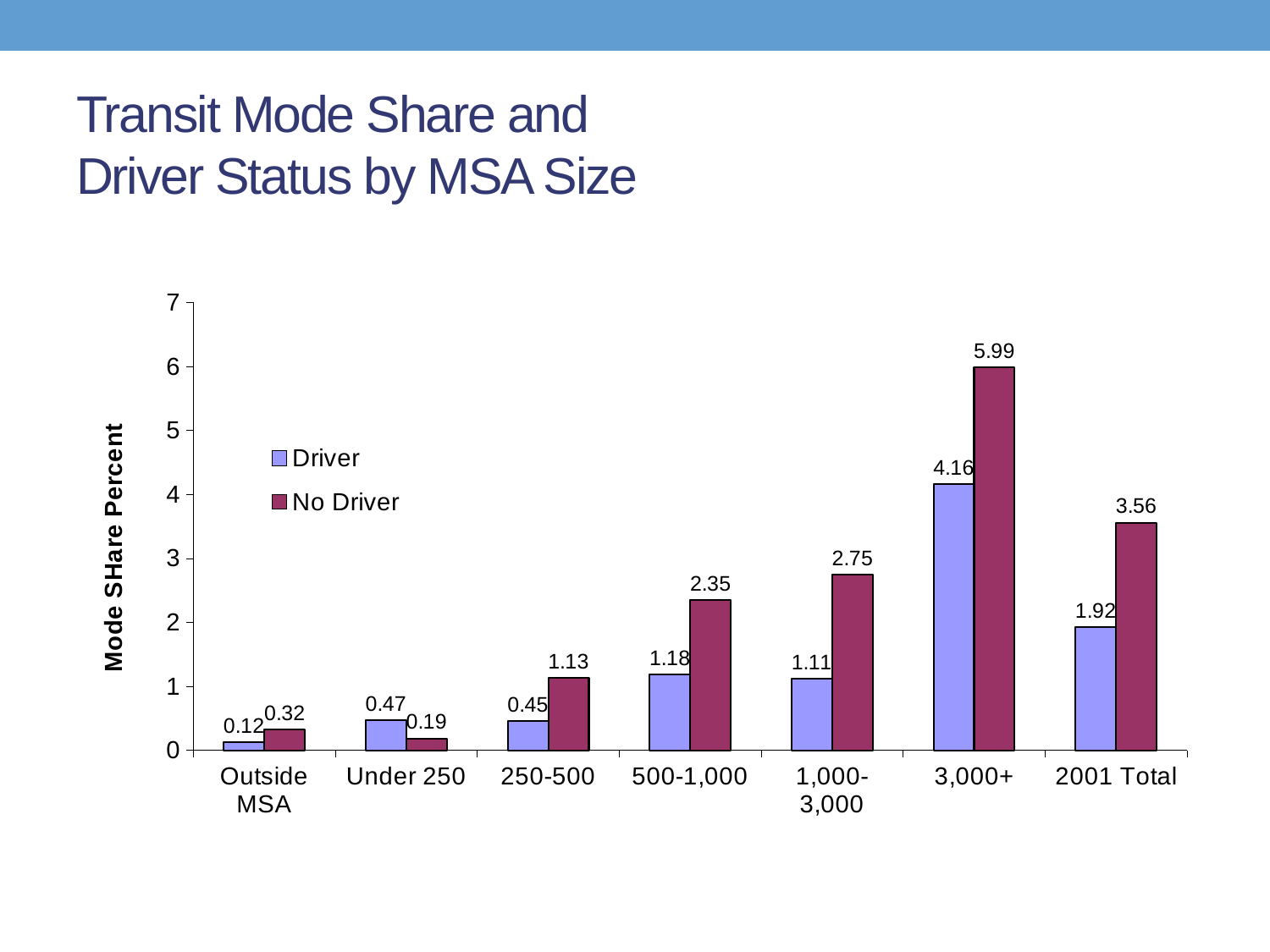
How many series does the legend list? 2 What is the No Driver value for the 500-1,000 category? 2.35 For the Under 250 category, which is larger, the Driver value or the No Driver value? Driver Which category has the highest No Driver value? 3,000+ What is the difference between the No Driver and Driver values for the 3,000+ category? 1.83 What is the No Driver value for 2001 Total? 3.56 What is the Driver value for the 3,000+ category? 4.16 What is the label of the y axis? Mode SHare Percent Which category has the lowest Driver value? Outside MSA How many categories are shown on the x axis? 7 What kind of chart is shown on the slide? bar chart Is the No Driver value for 1,000-3,000 greater or less than 2? greater